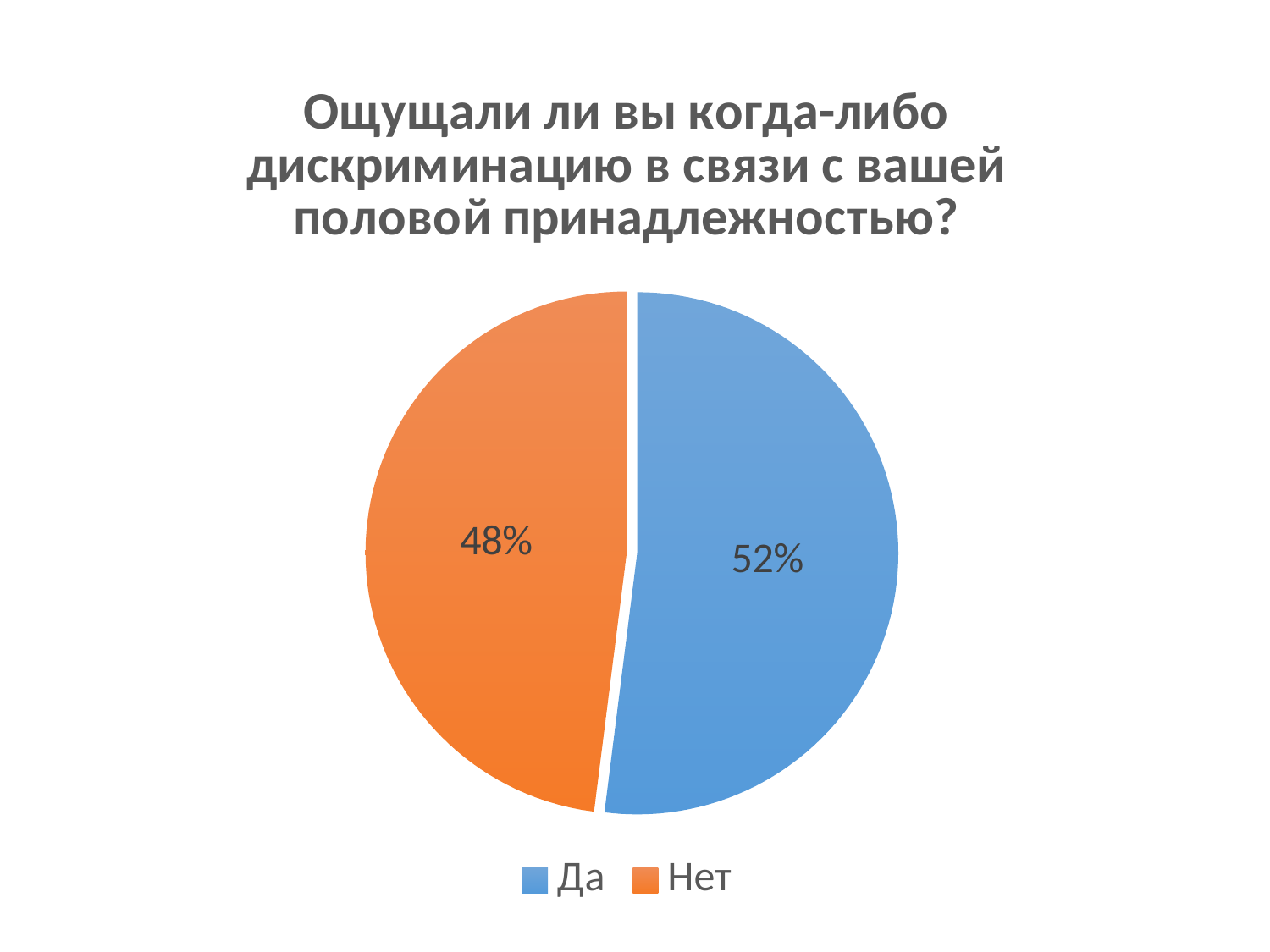
What colour is the slice for "Нет"? orange What kind of chart is shown on the slide? pie chart What is the value for "Да"? 52% Which category has the smallest share of the pie? Нет What is the value for "Нет"? 48% Which is larger, the share for "Да" or the share for "Нет"? Да What is the difference between the shares for "Да" and "Нет"? 4% Which category has the largest share of the pie? Да How many slices does the pie chart have? 2 What is the title of the chart? Ощущали ли вы когда-либо дискриминацию в связи с вашей половой принадлежностью? How many entries does the legend list? 2